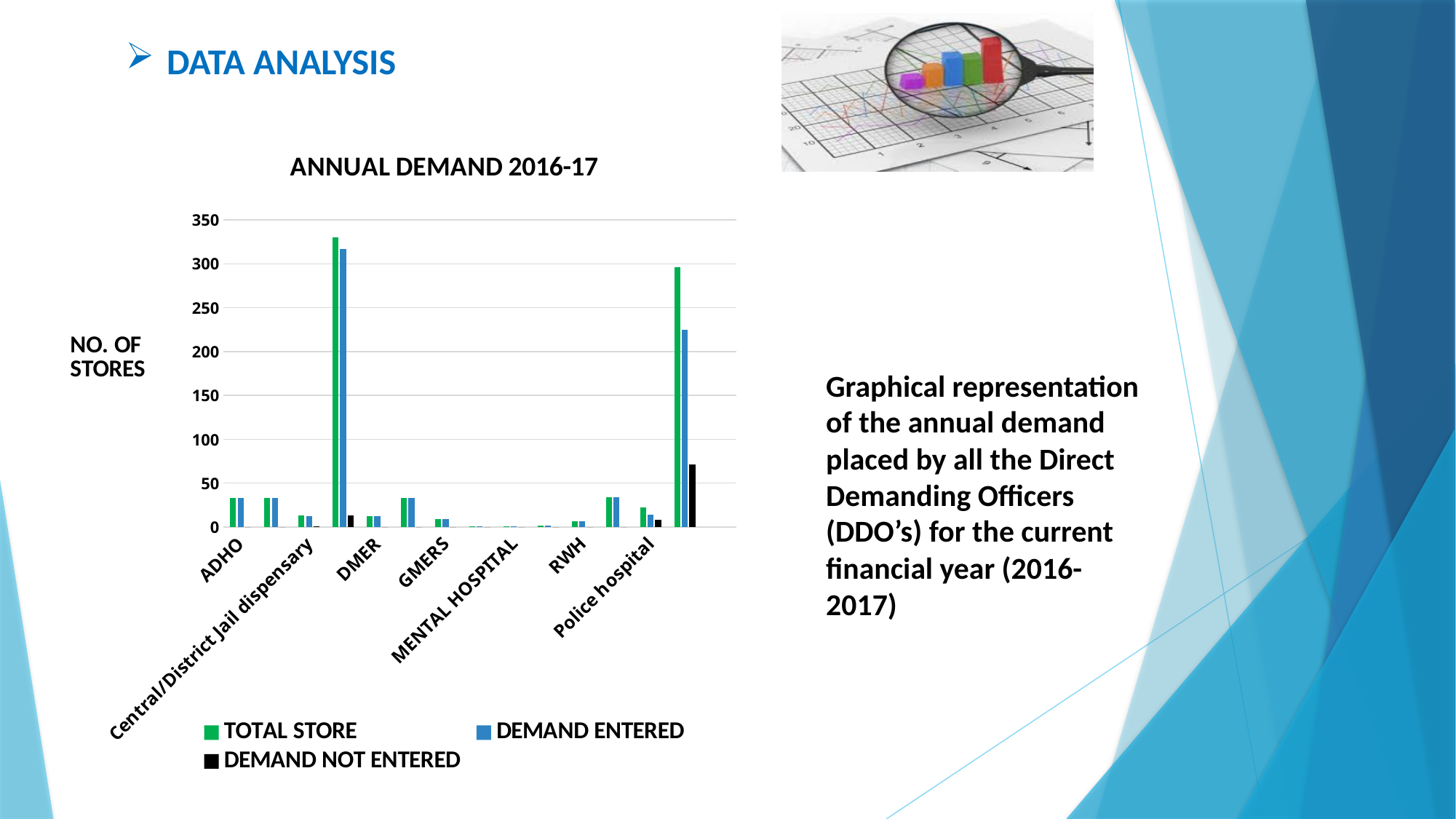
Which series is shown in black in the chart? DEMAND NOT ENTERED What kind of chart is shown on the slide? bar chart What is the title of the chart? ANNUAL DEMAND 2016-17 Is the DEMAND ENTERED value for GMERS greater or less than 100? less Which is larger, the TOTAL STORE value for ADHO or the TOTAL STORE value for DMER? ADHO Is the TOTAL STORE value for ADHO greater or less than 100? less For Police hospital, which is larger, the TOTAL STORE value or the DEMAND NOT ENTERED value? TOTAL STORE Is the DEMAND NOT ENTERED value for Police hospital greater or less than 50? less Which is larger, the TOTAL STORE value for RWH or the TOTAL STORE value for MENTAL HOSPITAL? RWH How many series does the chart's legend list? 3